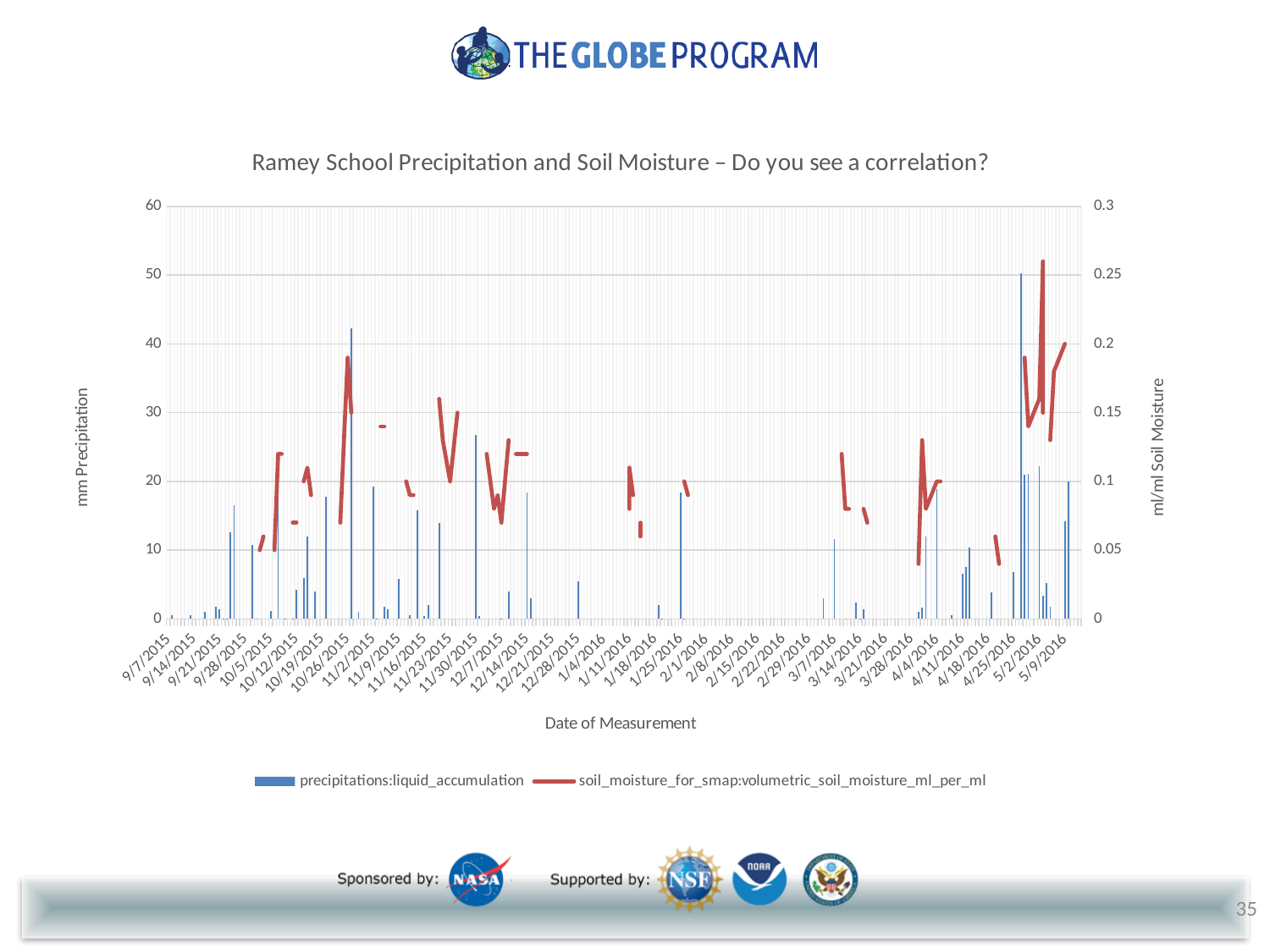
Which series is drawn as a red line? soil_moisture_for_smap:volumetric_soil_moisture_ml_per_ml What is the highest value shown on the left precipitation axis? 60 What kind of chart is shown on the slide? A combination bar and line chart What is the label of the left vertical axis? mm Precipitation What is the highest value shown on the right soil moisture axis? 0.3 Is the peak soil moisture value near 5/2/2016 greater or less than 0.2 ml/ml? greater What is the label of the horizontal axis? Date of Measurement How many series does the chart legend list? 2 What is the label of the right vertical axis? ml/ml Soil Moisture What is the title of the chart? Ramey School Precipitation and Soil Moisture – Do you see a correlation? Is the tallest precipitation bar, near 5/2/2016, greater or less than 40 mm? greater Is the precipitation bar near 10/26/2015 greater or less than 30 mm? greater